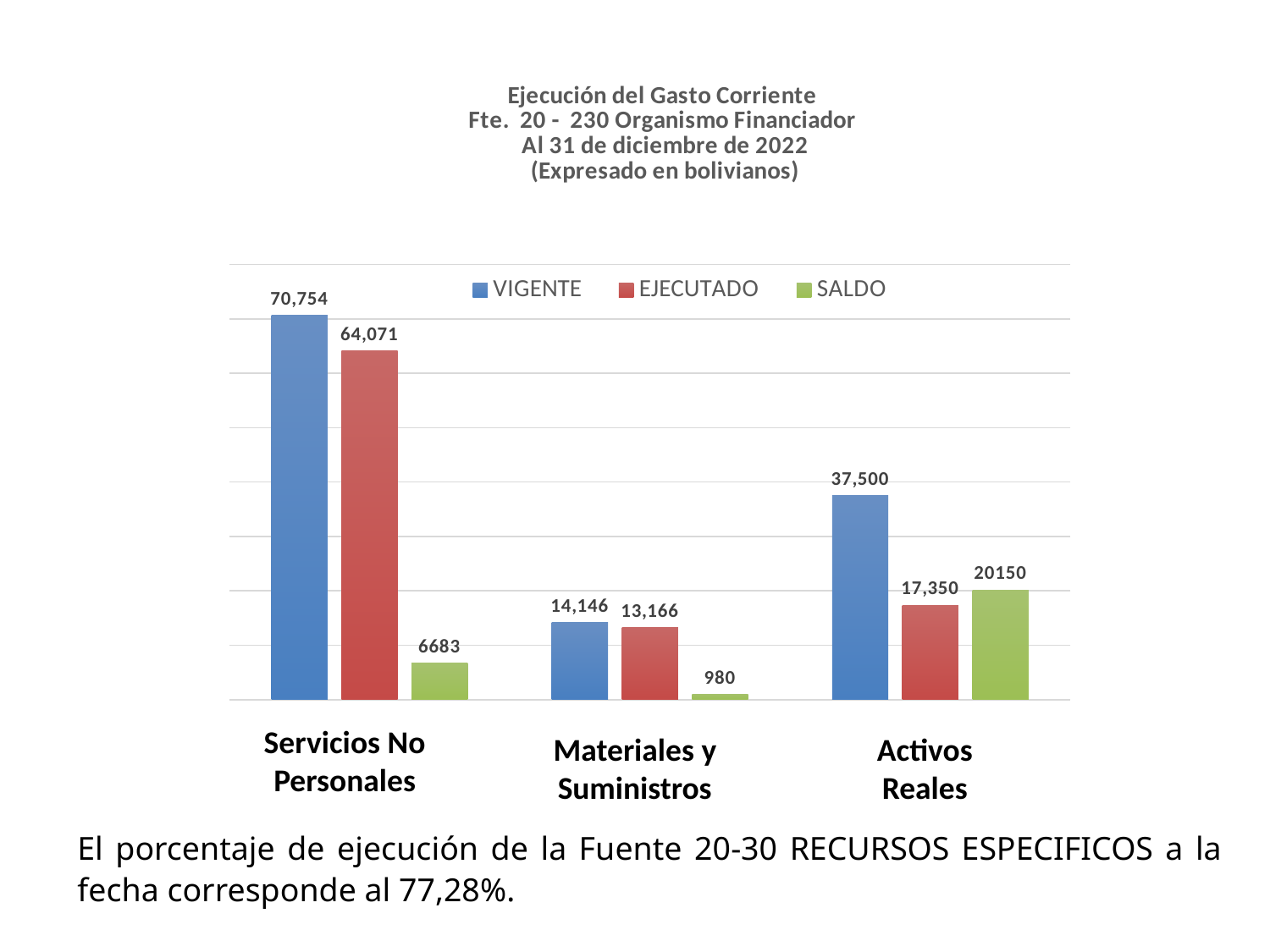
What is the SALDO value for Activos Reales? 20150 How many series does the legend list? 3 Which series is shown in green in the legend? SALDO How many categories are shown on the x axis? 3 What is the SALDO value for Servicios No Personales? 6683 What is the difference between the VIGENTE and EJECUTADO values for Activos Reales? 20,150 What is the EJECUTADO value for Materiales y Suministros? 13,166 What kind of chart is shown on the slide? Bar chart Which is larger for Activos Reales, the EJECUTADO value or the SALDO value? SALDO Which category has the lowest SALDO value? Materiales y Suministros Which category has the highest VIGENTE value? Servicios No Personales What is the VIGENTE value for Servicios No Personales? 70,754